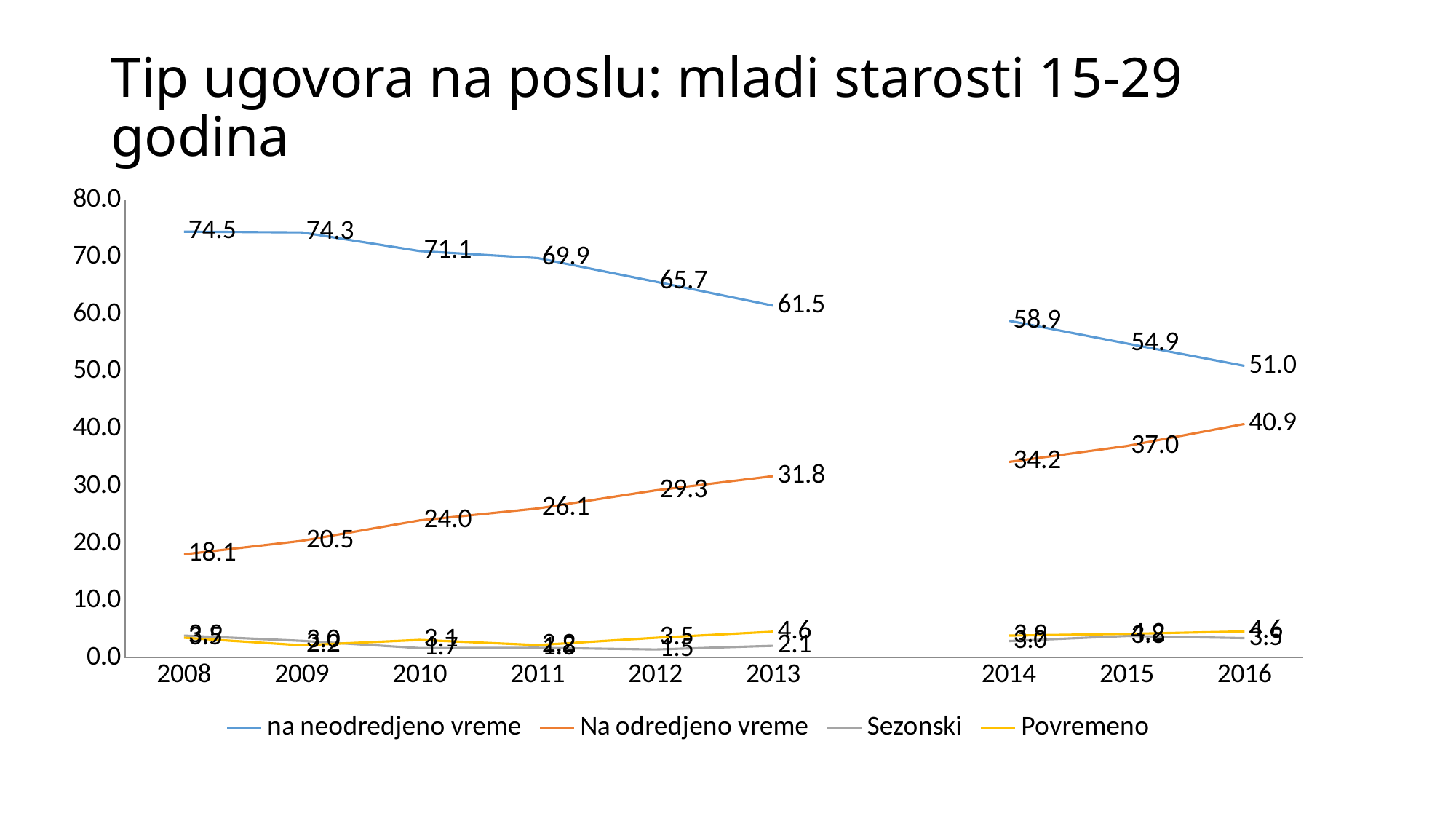
How many series does the legend list? 4 What is the value for 'Na odredjeno vreme' in 2016? 40.9 In which year is the 'na neodredjeno vreme' series lowest? 2016 What type of chart is shown on the slide? line chart What is the value for 'na neodredjeno vreme' in 2013? 61.5 How many years are shown on the x axis? 9 What is the value for 'na neodredjeno vreme' in 2008? 74.5 What is the value for 'Povremeno' in 2013? 4.6 In which year is the 'Na odredjeno vreme' series highest? 2016 What is the difference between the 'na neodredjeno vreme' values in 2008 and 2016? 23.5 Does the 'Na odredjeno vreme' series rise or fall from 2008 to 2016? rise Which is larger in 2014: 'na neodredjeno vreme' or 'Na odredjeno vreme'? na neodredjeno vreme